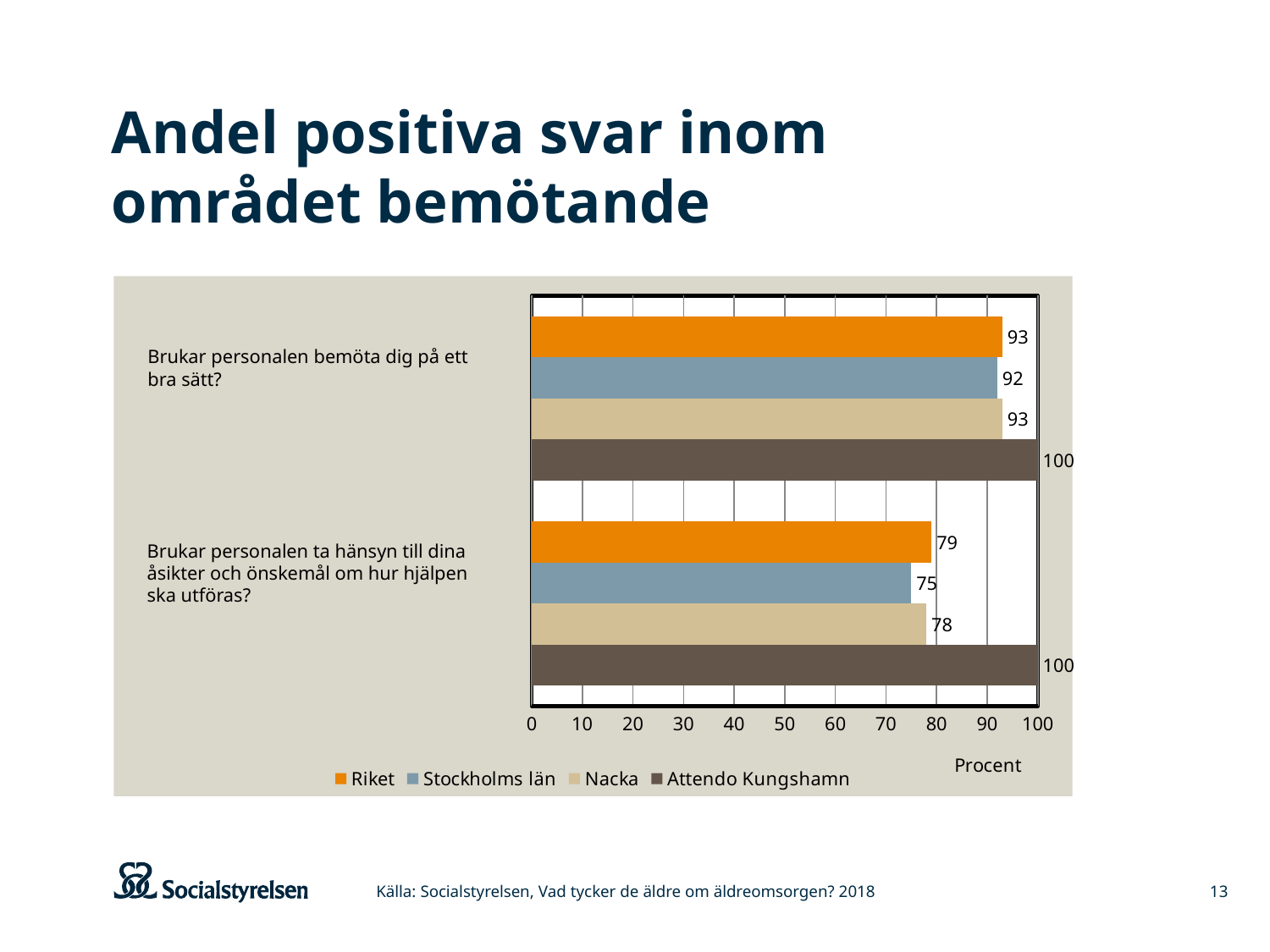
What is the value for Stockholms län on the question "Brukar personalen ta hänsyn till dina åsikter och önskemål om hur hjälpen ska utföras?"? 75 What is the value for Nacka on the question "Brukar personalen ta hänsyn till dina åsikter och önskemål om hur hjälpen ska utföras?"? 78 How many series does the legend list? 4 Which series has the lowest value on the question "Brukar personalen ta hänsyn till dina åsikter och önskemål om hur hjälpen ska utföras?"? Stockholms län What is the value for Attendo Kungshamn on the question "Brukar personalen bemöta dig på ett bra sätt?"? 100 What is the label on the horizontal axis of the chart? Procent What is the difference between Attendo Kungshamn and Riket on the question "Brukar personalen ta hänsyn till dina åsikter och önskemål om hur hjälpen ska utföras?"? 21 What kind of chart is shown on the slide? Bar chart How many questions (categories) are shown on the chart? 2 What is the value for Riket on the question "Brukar personalen bemöta dig på ett bra sätt?"? 93 Which series has the highest value on the question "Brukar personalen ta hänsyn till dina åsikter och önskemål om hur hjälpen ska utföras?"? Attendo Kungshamn Which is larger on the question "Brukar personalen bemöta dig på ett bra sätt?": Riket or Stockholms län? Riket